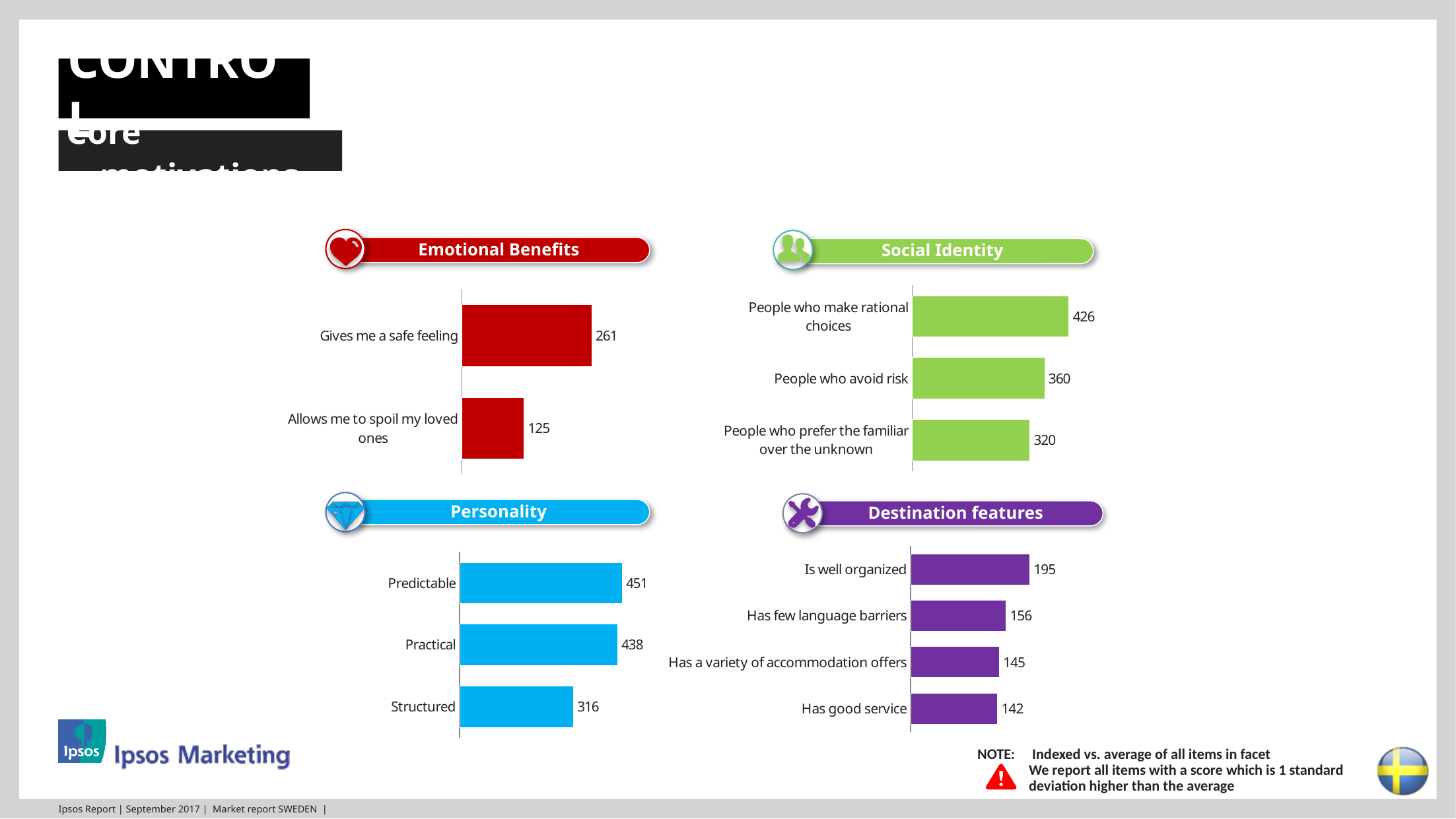
In the Destination features chart, which is larger: "Has few language barriers" or "Has good service"? Has few language barriers In the Personality chart, what is the difference between "Predictable" and "Structured"? 135 In the Social Identity chart, what is the value for "People who prefer the familiar over the unknown"? 320 In the Social Identity chart, which category has the highest value? People who make rational choices In the Personality chart, what is the value for "Practical"? 438 In the Emotional Benefits chart, what is the value for "Gives me a safe feeling"? 261 In the Social Identity chart, how many categories are shown? 3 In the Destination features chart, how many categories are shown? 4 In the Personality chart, which category has the lowest value? Structured What kind of chart is the Destination features chart? Bar chart What colour are the bars in the Social Identity chart? Green In the Emotional Benefits chart, what is the difference between "Gives me a safe feeling" and "Allows me to spoil my loved ones"? 136